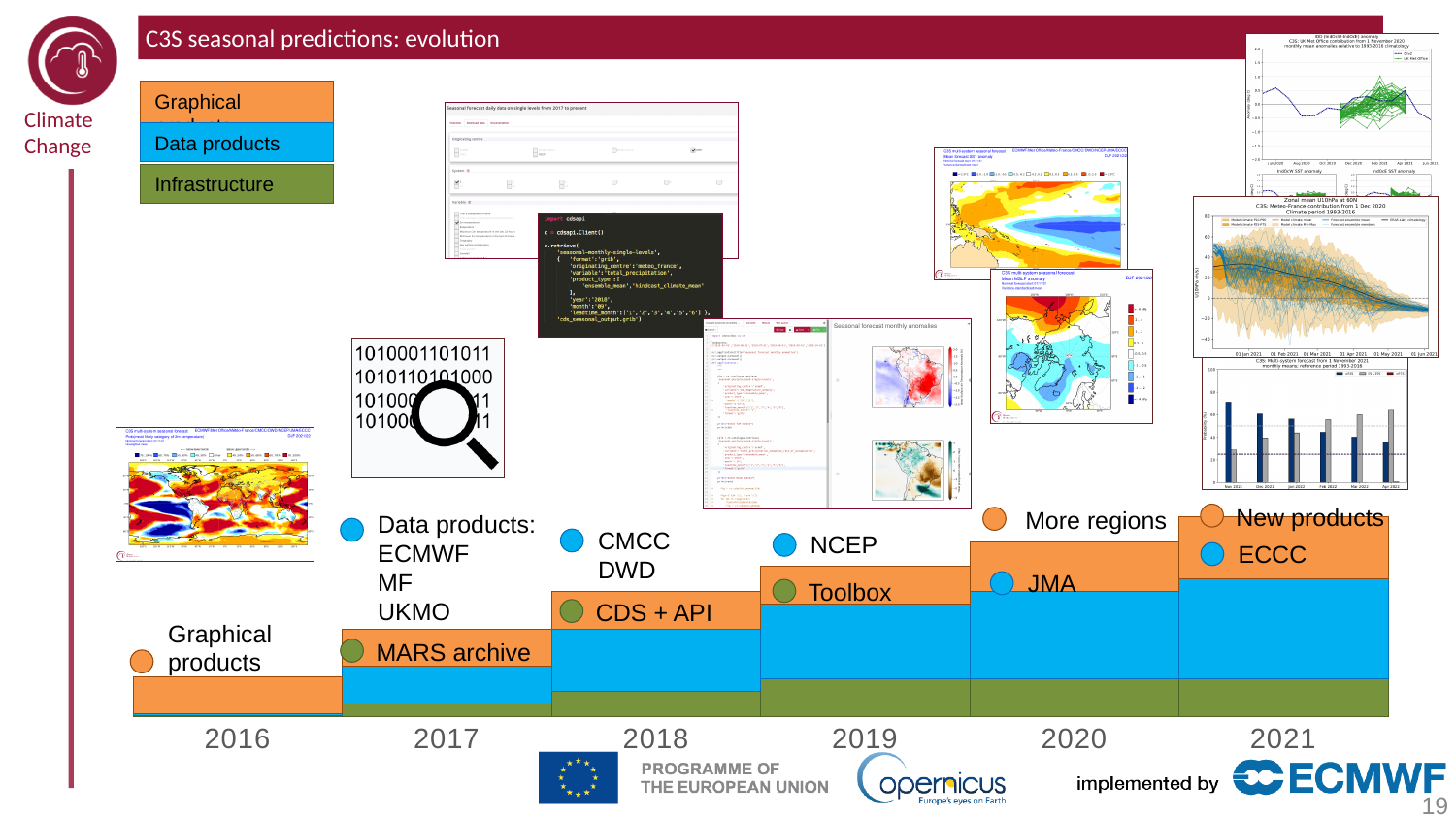
Which year has the tallest stacked bar in the timeline chart? 2021 Which stacked bar is taller, 2019 or 2017? 2019 Which colour represents Data products in the legend? blue How many categories does the legend at the top left of the slide list? 3 Which year has the shortest stacked bar in the timeline chart? 2016 Which stacked bar is taller, 2016 or 2021? 2021 What kind of chart is the timeline at the bottom of the slide? bar chart Which stacked bar is taller, 2018 or 2020? 2020 Do the stacked bars rise or fall from 2016 to 2021? rise What is the title of the slide containing the timeline chart? C3S seasonal predictions: evolution How many years are shown along the x axis of the timeline chart? 6